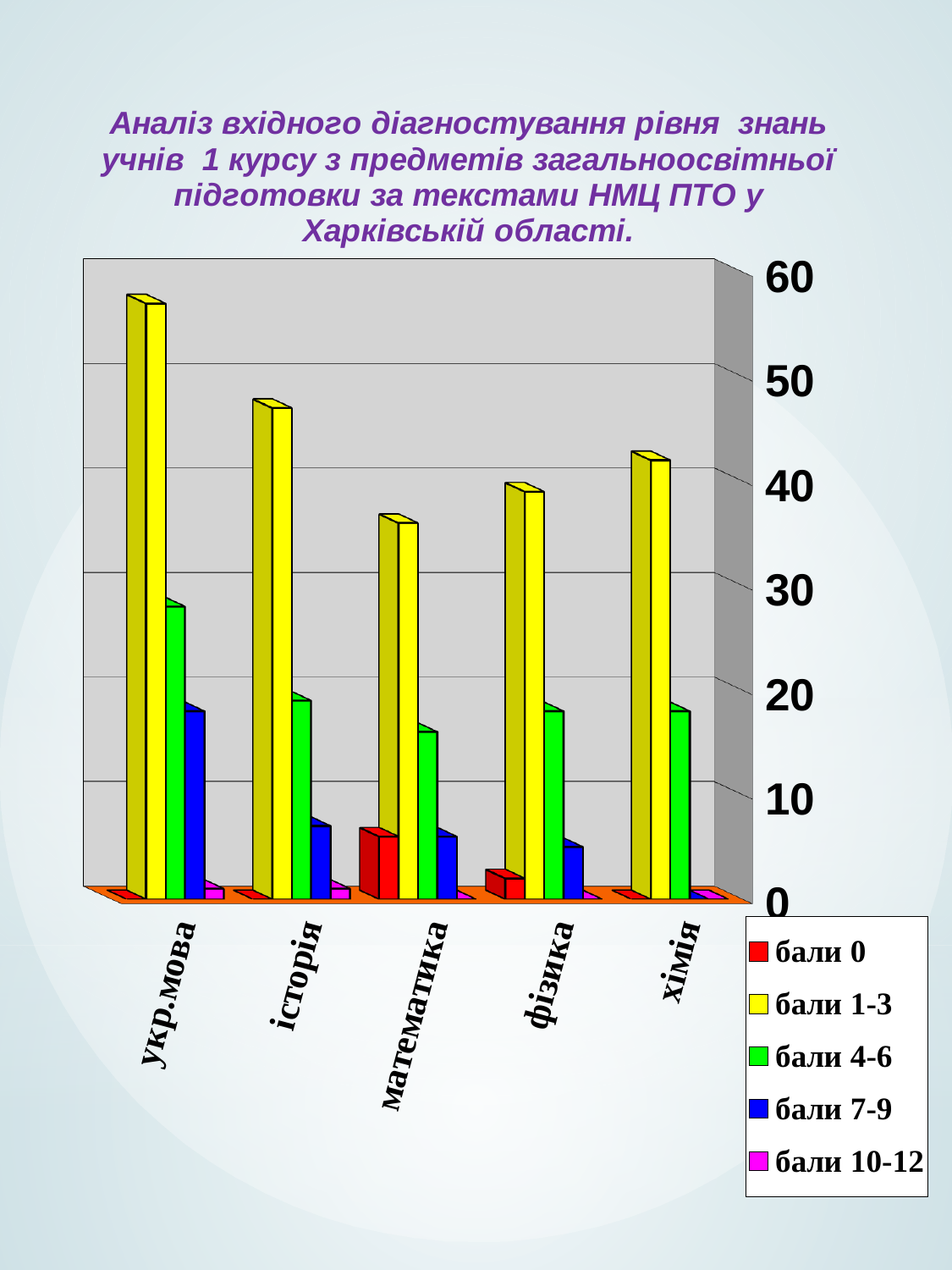
What kind of chart is shown on the slide? bar chart Which subject has the highest value for бали 4-6? укр.мова Which subject has the highest value for бали 7-9? укр.мова How many series does the legend list? 5 Which colour represents the series бали 7-9 in the legend? blue Which is larger: бали 1-3 for історія or бали 1-3 for хімія? історія Is the value for бали 4-6 in укр.мова greater or less than 20? greater Which subject has the highest value for бали 1-3? укр.мова How many subject categories are shown on the x axis? 5 Is the value for бали 1-3 in математика greater or less than 40? less Which subject has the lowest value for бали 1-3? математика Is the value for бали 1-3 in укр.мова greater or less than 50? greater